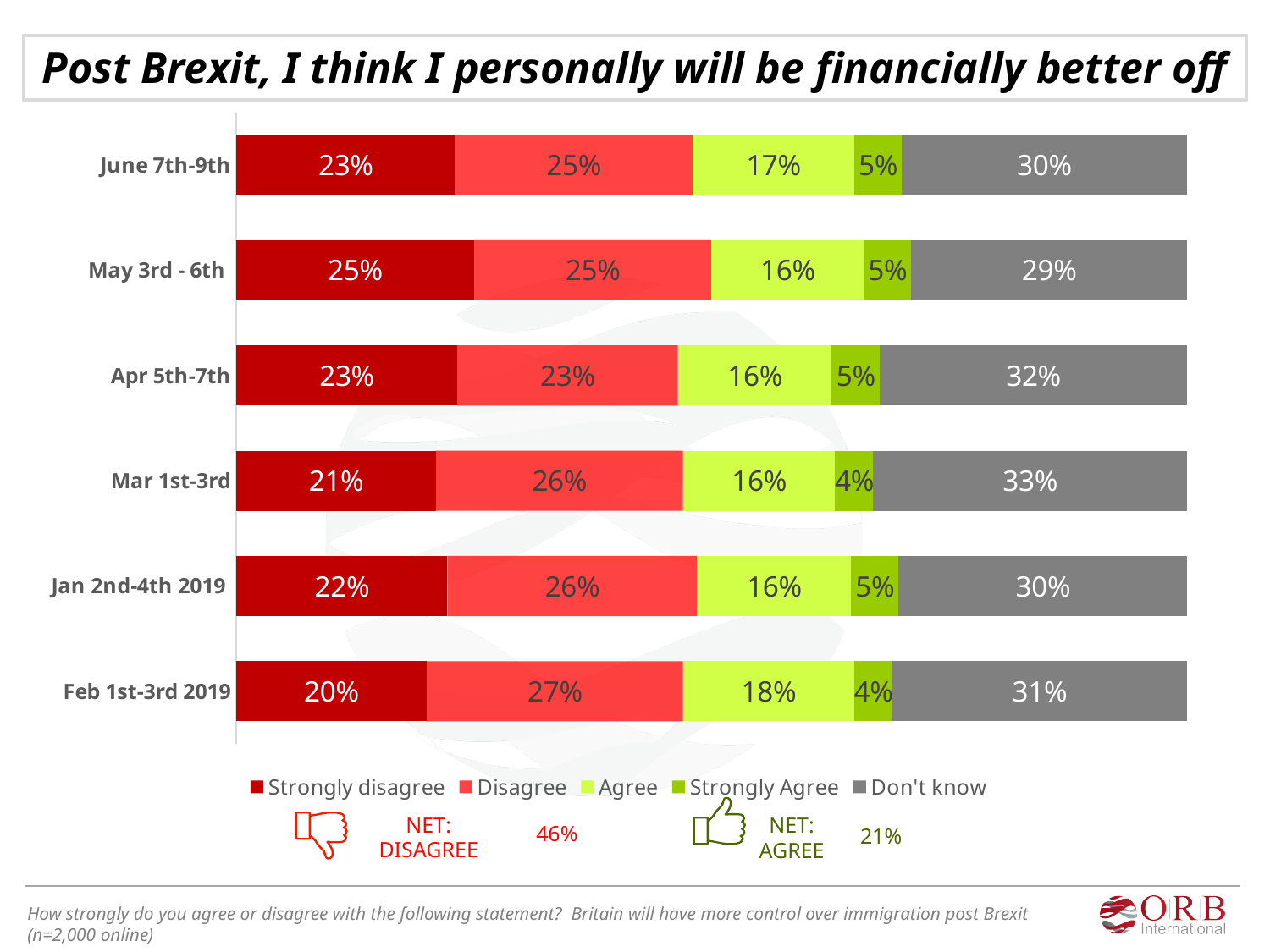
What is the Strongly disagree value for May 3rd - 6th? 25% What NET: DISAGREE figure is shown below the chart? 46% What is the combined Strongly disagree and Disagree value for June 7th-9th? 48% What is the Strongly Agree value for Feb 1st-3rd 2019? 4% How many series does the legend list? 5 What is the difference between the Disagree value for Feb 1st-3rd 2019 and the Disagree value for June 7th-9th? 2 percentage points What kind of chart is shown on the slide? Stacked bar chart What is the Don't know value for Mar 1st-3rd? 33% Which survey period has the highest Don't know value? Mar 1st-3rd Which has the larger Agree value, June 7th-9th or Apr 5th-7th? June 7th-9th Which survey period has the lowest Strongly disagree value? Feb 1st-3rd 2019 How many survey periods are shown on the chart? 6